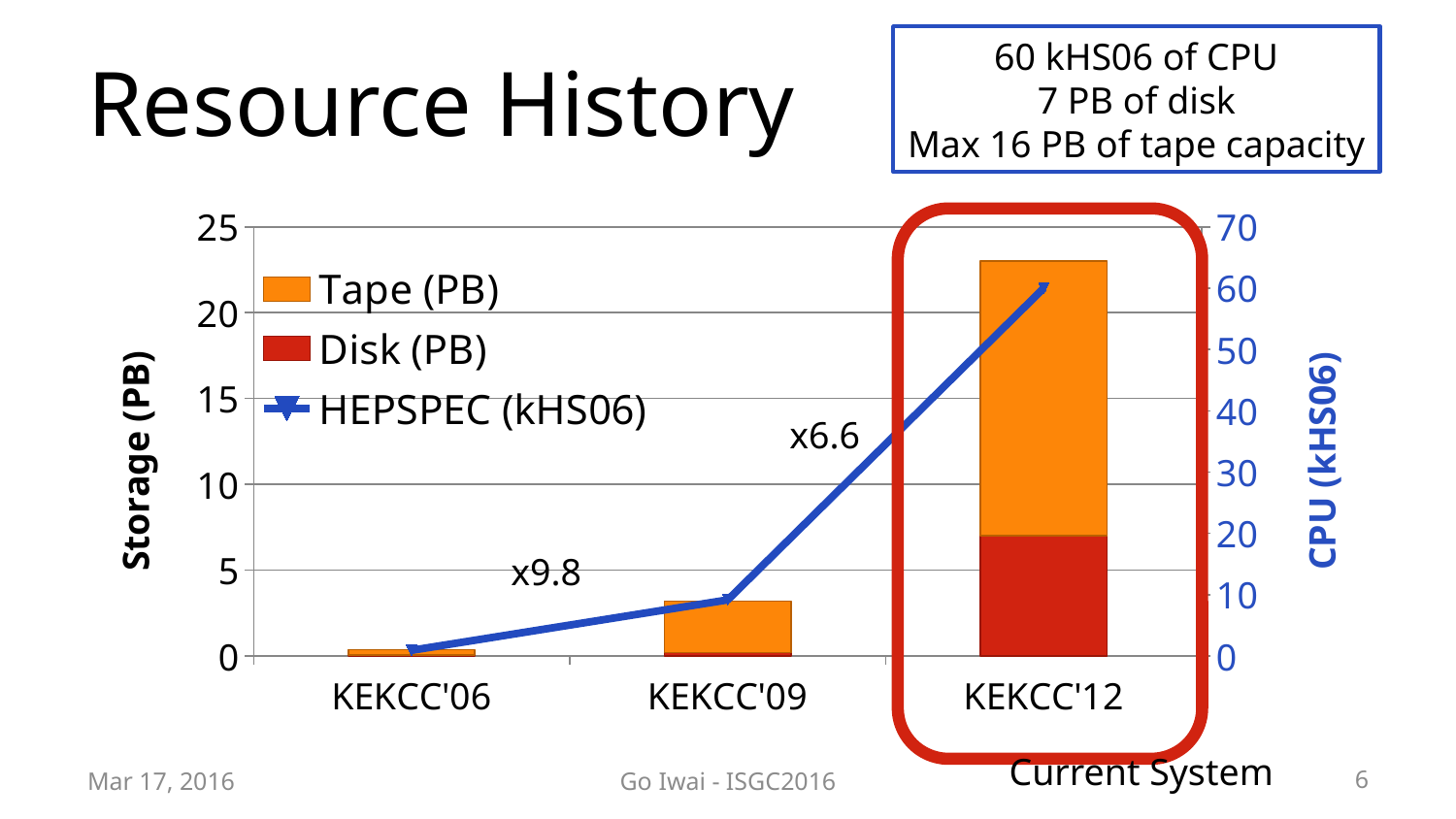
How many categories are shown on the x axis of the chart? 3 How many series does the chart's legend list? 3 Is the total storage bar for KEKCC'12 greater or less than 20 PB? greater Which category has the smallest storage bar? KEKCC'06 Is the total storage bar for KEKCC'09 greater or less than 5 PB? less What growth factor is annotated on the HEPSPEC line between KEKCC'06 and KEKCC'09? x9.8 What is the HEPSPEC (kHS06) value at KEKCC'12? 60 Which category has the tallest storage bar? KEKCC'12 What is the title of the right-hand vertical axis? CPU (kHS06) What kind of chart is used to show the Tape and Disk storage values? bar chart Does the HEPSPEC (kHS06) line rise or fall from KEKCC'06 to KEKCC'12? rise